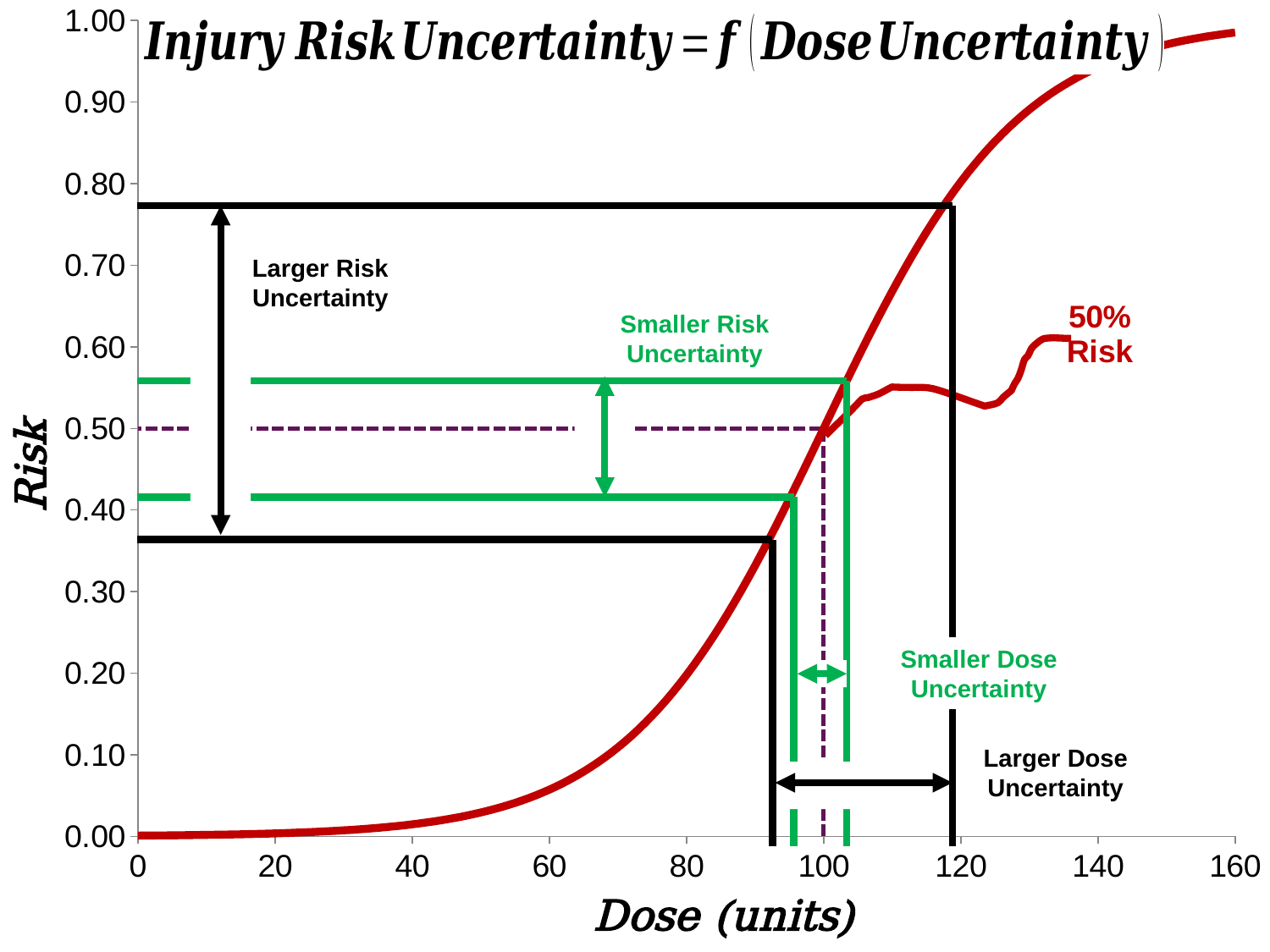
Is the risk at a dose of 80 units greater or less than 0.30? less At what dose does the dashed line mark the 50% risk level? 100 Which is larger, the risk at a dose of 120 units or the risk at a dose of 80 units? 120 units Is the risk at a dose of 40 units greater or less than 0.10? less Does the risk rise or fall as dose increases along the x axis? rise Is the risk at a dose of 20 units greater or less than 0.10? less What is the label on the x axis of the chart? Dose (units) What is the title of the chart? Injury Risk Uncertainty = f(Dose Uncertainty) What type of chart is shown on the slide? line chart